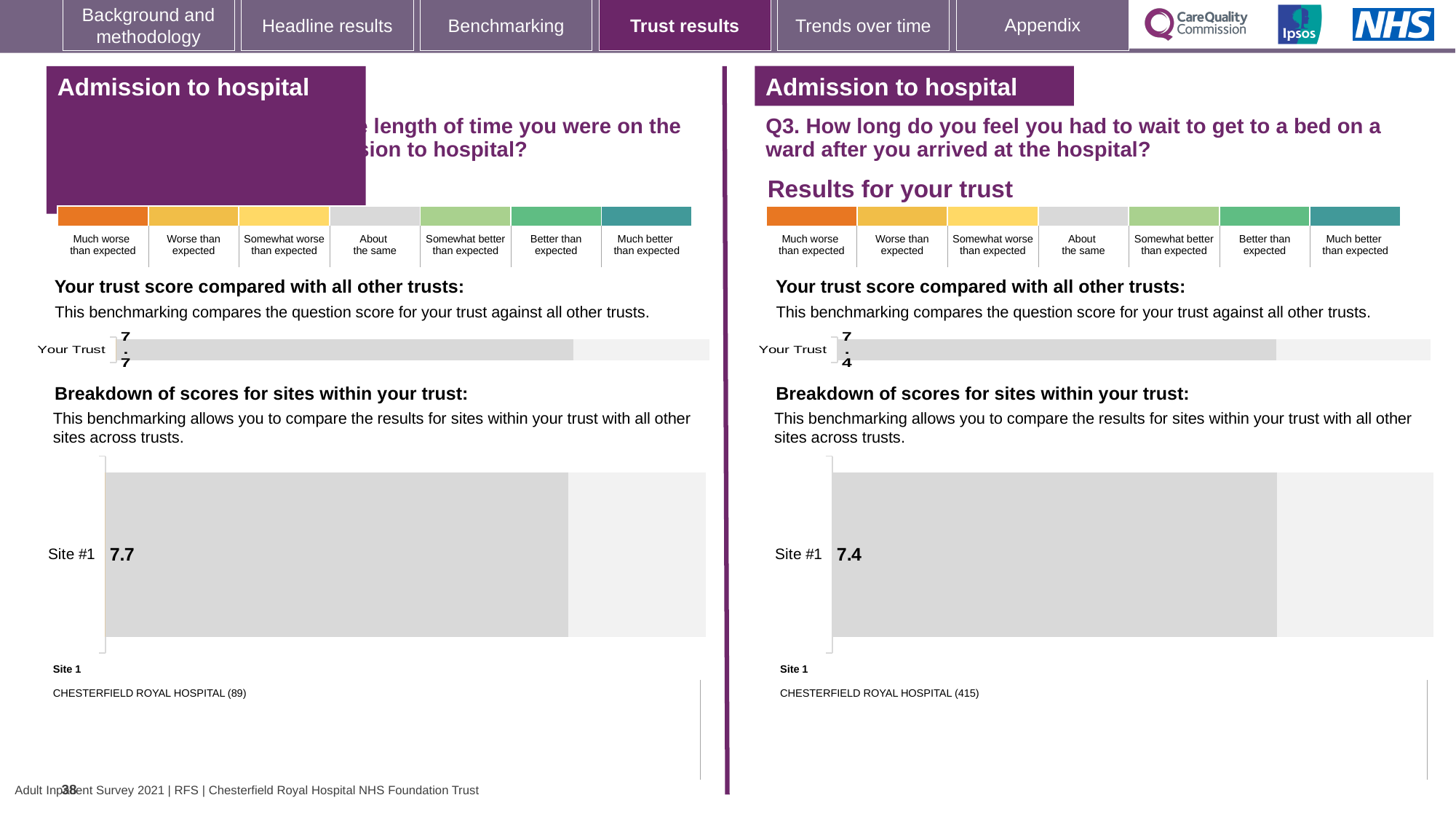
On the right-hand side of the slide (Q3), what is the score shown for Your Trust? 7.4 On the left-hand side of the slide, what is the score shown for Your Trust? 7.7 What kind of chart is used to show the Site #1 score on the right-hand side of the slide (Q3)? Bar chart In the right-hand 'Breakdown of scores for sites within your trust' chart (Q3), what is the score for Site #1? 7.4 On the right-hand side of the slide (Q3), what is the name of Site 1 and how many respondents are shown in brackets? CHESTERFIELD ROYAL HOSPITAL (415) How many sites are shown in the right-hand 'Breakdown of scores for sites within your trust' chart (Q3)? 1 What kind of chart is used to show the Your Trust score on the left-hand side of the slide? Bar chart What is the difference between the Site #1 score on the left-hand side of the slide and the Site #1 score on the right-hand side (Q3)? 0.3 In the left-hand 'Breakdown of scores for sites within your trust' chart, what is the score for Site #1? 7.7 How many sites are shown in the left-hand 'Breakdown of scores for sites within your trust' chart? 1 Which is larger: the Your Trust score on the left-hand side of the slide or the Your Trust score on the right-hand side (Q3)? Left-hand side (7.7) On the left-hand side of the slide, how many respondents are shown in brackets next to CHESTERFIELD ROYAL HOSPITAL for Site 1? 89